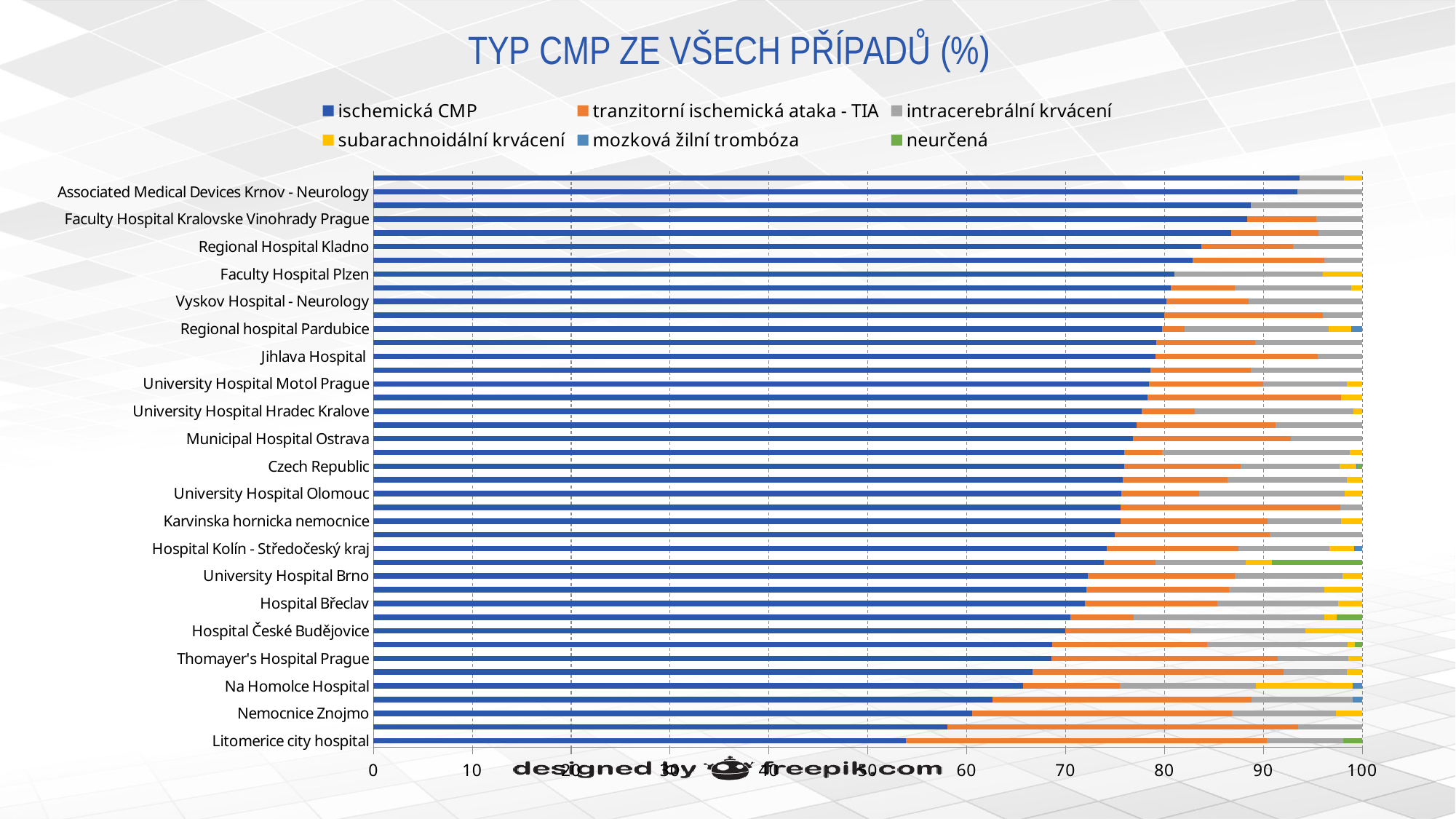
Is the value of ischemická CMP for Na Homolce Hospital greater or less than 70? less How many series does the legend list? 6 Is the value of ischemická CMP for Czech Republic greater or less than 70? greater Is the value of ischemická CMP for University Hospital Brno greater or less than 80? less Which colour represents the series 'ischemická CMP' in the chart? blue Which has a larger ischemická CMP share, Litomerice city hospital or Associated Medical Devices Krnov - Neurology? Associated Medical Devices Krnov - Neurology What kind of chart is shown on the slide? bar chart Which labelled category has the lowest ischemická CMP share? Litomerice city hospital What is the title of the chart? TYP CMP ZE VŠECH PŘÍPADŮ (%)